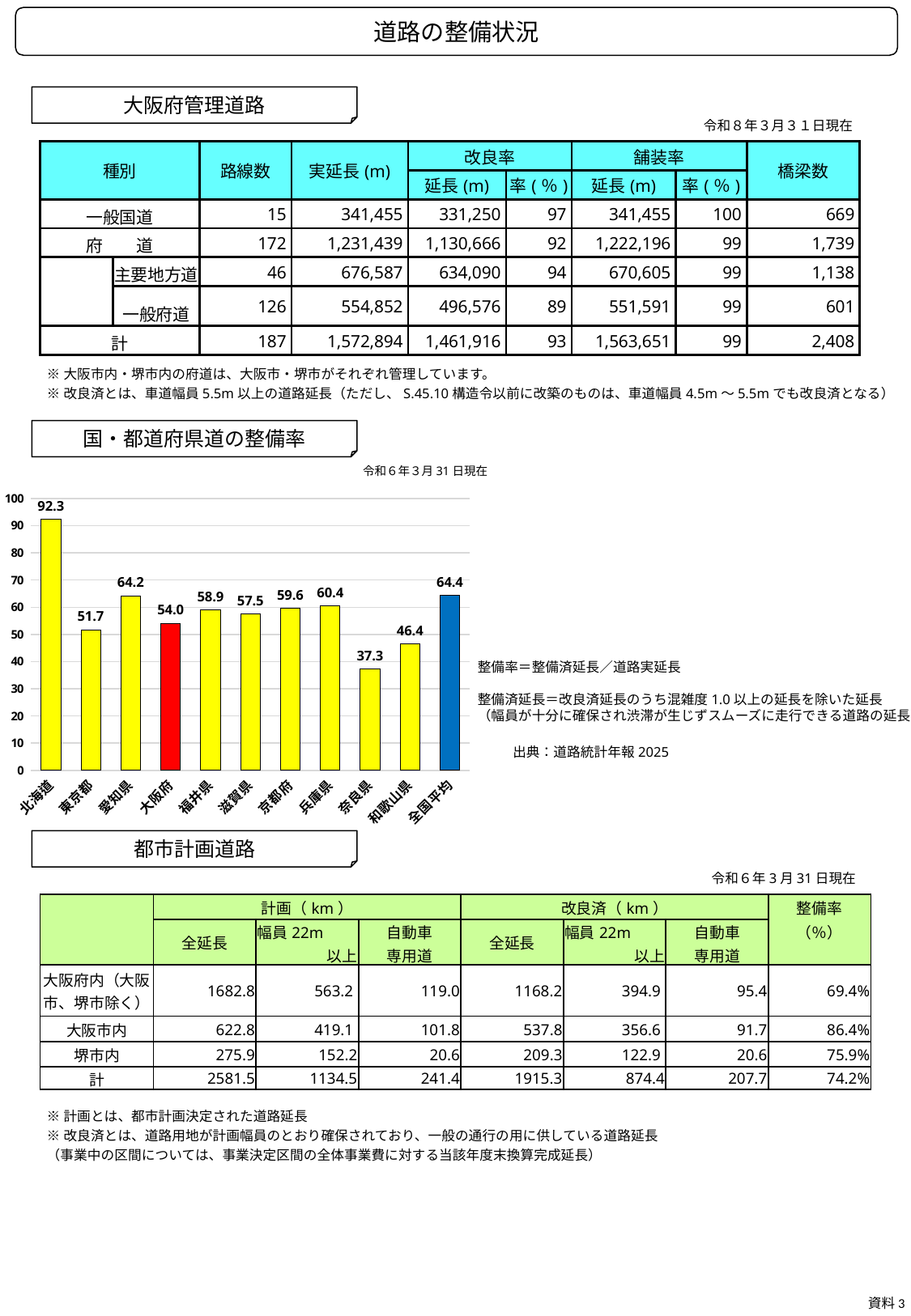
In the 国・都道府県道の整備率 chart, which is larger, the value for 兵庫県 or the value for 京都府? 兵庫県 In the 国・都道府県道の整備率 chart, what is the value for 全国平均? 64.4 In the 国・都道府県道の整備率 chart, which category has the highest value? 北海道 In the 国・都道府県道の整備率 chart, is the value for 和歌山県 greater or less than 50? less What kind of chart is the 国・都道府県道の整備率 chart? bar chart In the 国・都道府県道の整備率 chart, what is the difference between the values for 北海道 and 東京都? 40.6 In the 国・都道府県道の整備率 chart, what is the value for 大阪府? 54.0 In the 国・都道府県道の整備率 chart, what is the difference between the values for 全国平均 and 大阪府? 10.4 In the 国・都道府県道の整備率 chart, what is the value for 奈良県? 37.3 In the 国・都道府県道の整備率 chart, which category has the lowest value? 奈良県 In the 国・都道府県道の整備率 chart, which bar is coloured red? 大阪府 How many bars are plotted in the 国・都道府県道の整備率 chart? 11